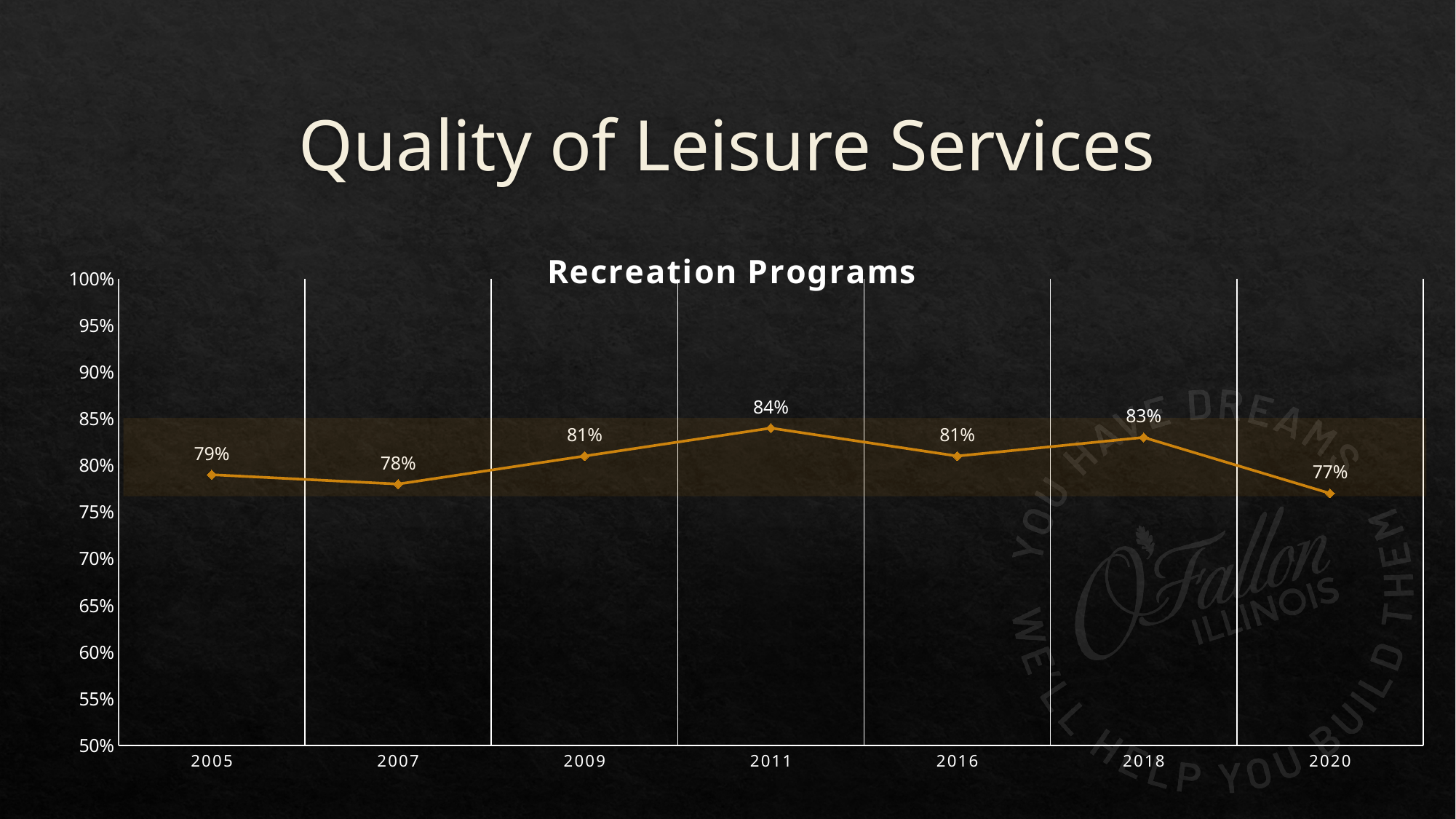
How many years are plotted on the chart? 7 What is the difference between the values for 2011 and 2007? 6% What is the title of the chart? Recreation Programs What is the value for 2011? 84% Which year has the highest value? 2011 Which year has the lowest value? 2020 Does the value rise or fall from 2018 to 2020? fall What is the value for 2005? 79% What kind of chart is shown? line chart What is the value for 2020? 77% What is the value for 2018? 83% Which is larger, the value for 2018 or the value for 2020? 2018